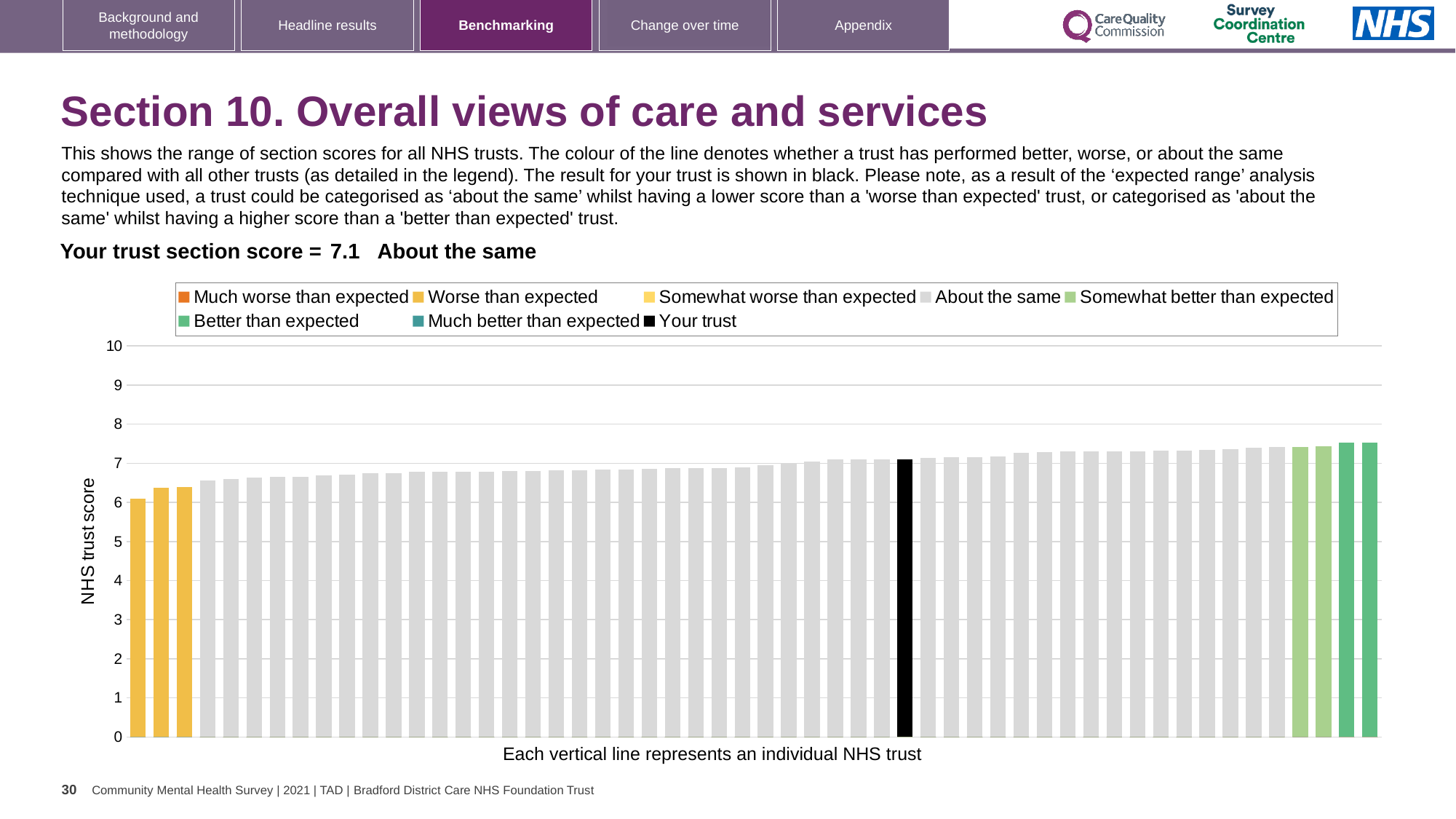
Is the value of the highest bar greater or less than 8? less Is the value of the lowest bar greater or less than 7? less How is your trust's section score categorised compared with other trusts? About the same What is the label on the vertical axis of the chart? NHS trust score How many entries does the chart legend list? 8 Do the bar values rise or fall from left to right along the x axis? rise What kind of chart is shown on the slide? bar chart What is the section score for your trust shown on the slide? 7.1 How many bars are shown in the 'Worse than expected' colour? 3 What colour is the bar representing your trust? black Is the value for your trust (the black bar) greater or less than 6? greater